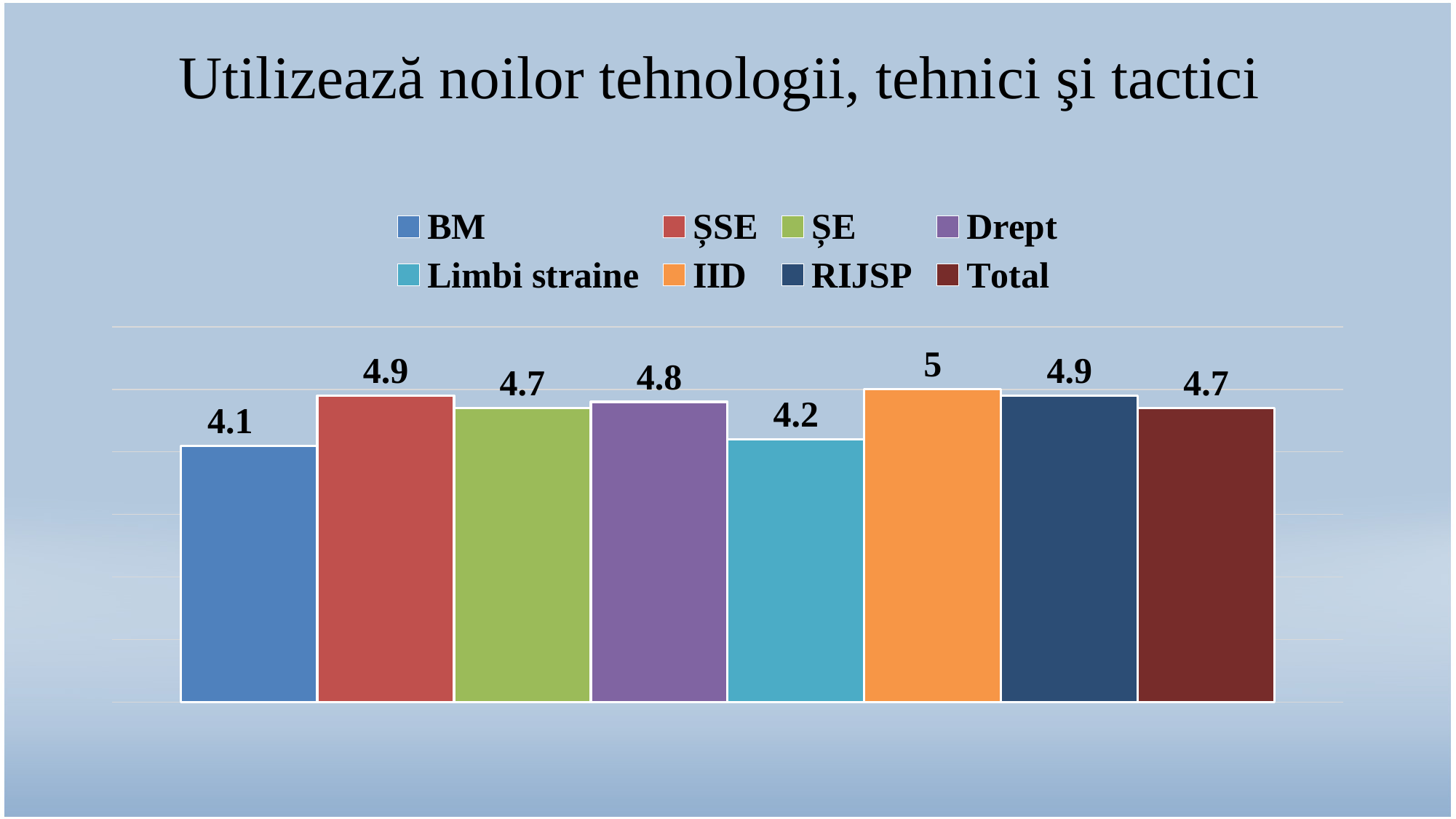
What is the value for IID? 5 Which series has the highest value? IID Which is larger, the value for Drept or the value for Limbi straine? Drept What is the difference between the values for ȘSE and Limbi straine? 0.7 What is the title of the chart? Utilizează noilor tehnologii, tehnici şi tactici What is the value for Limbi straine? 4.2 Which series has the lowest value? BM What is the value for BM? 4.1 How many series does the legend list? 8 What is the value for Total? 4.7 What kind of chart is shown on the slide? bar chart What is the difference between the values for IID and BM? 0.9